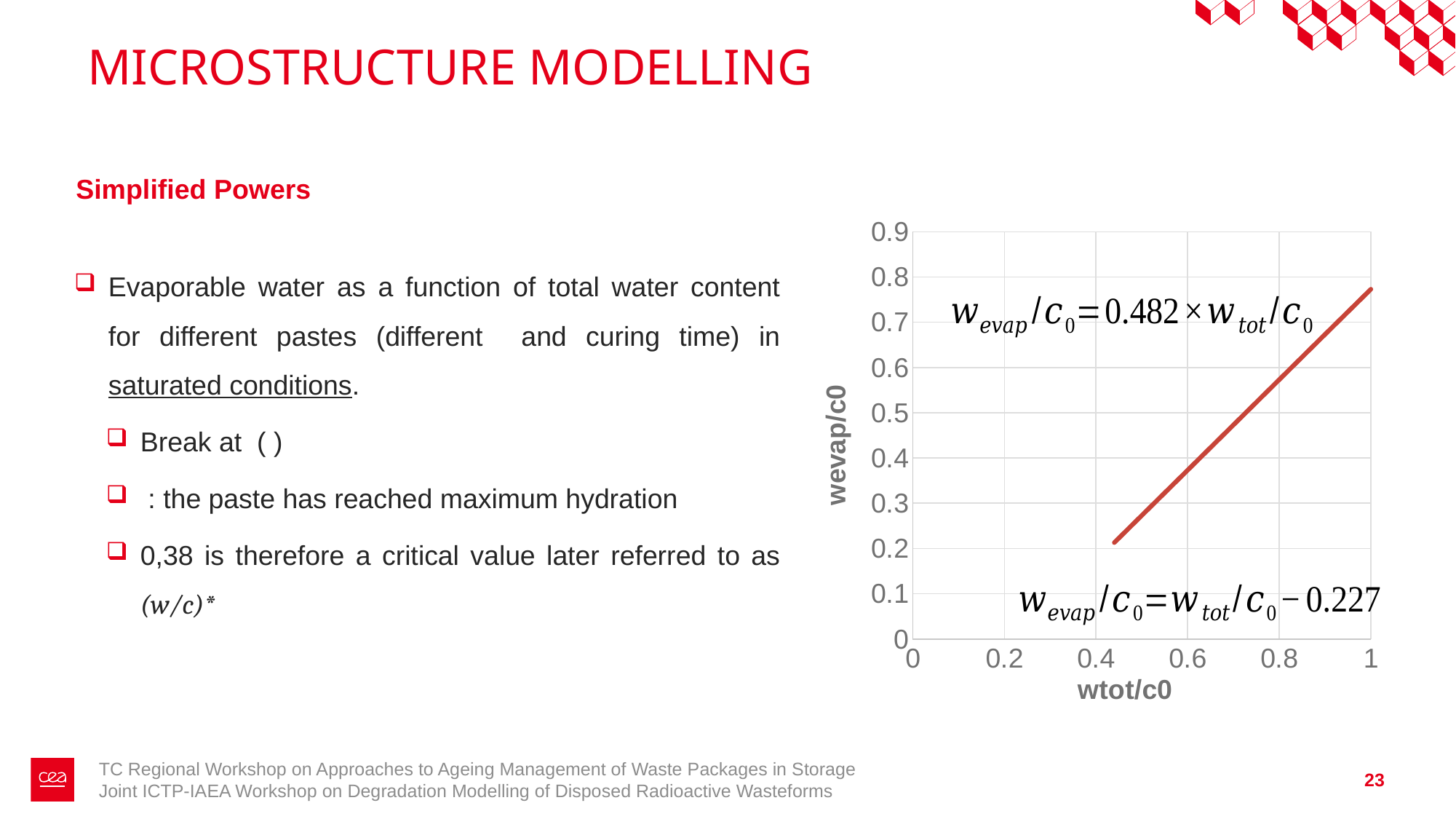
Is the value of wevap/c0 at wtot/c0 = 1 greater or less than 0.7? greater What kind of chart is shown on the slide? line chart Is the value of wevap/c0 at wtot/c0 = 0.6 greater or less than 0.3? greater How many lines are plotted on the chart? 1 What is the label of the x axis of the chart? wtot/c0 Does the plotted line rise or fall as wtot/c0 increases? rise What is the label of the y axis of the chart? wevap/c0 What is the highest tick value shown on the y axis of the chart? 0.9 Is the value of wevap/c0 at wtot/c0 = 0.5 greater or less than 0.4? less